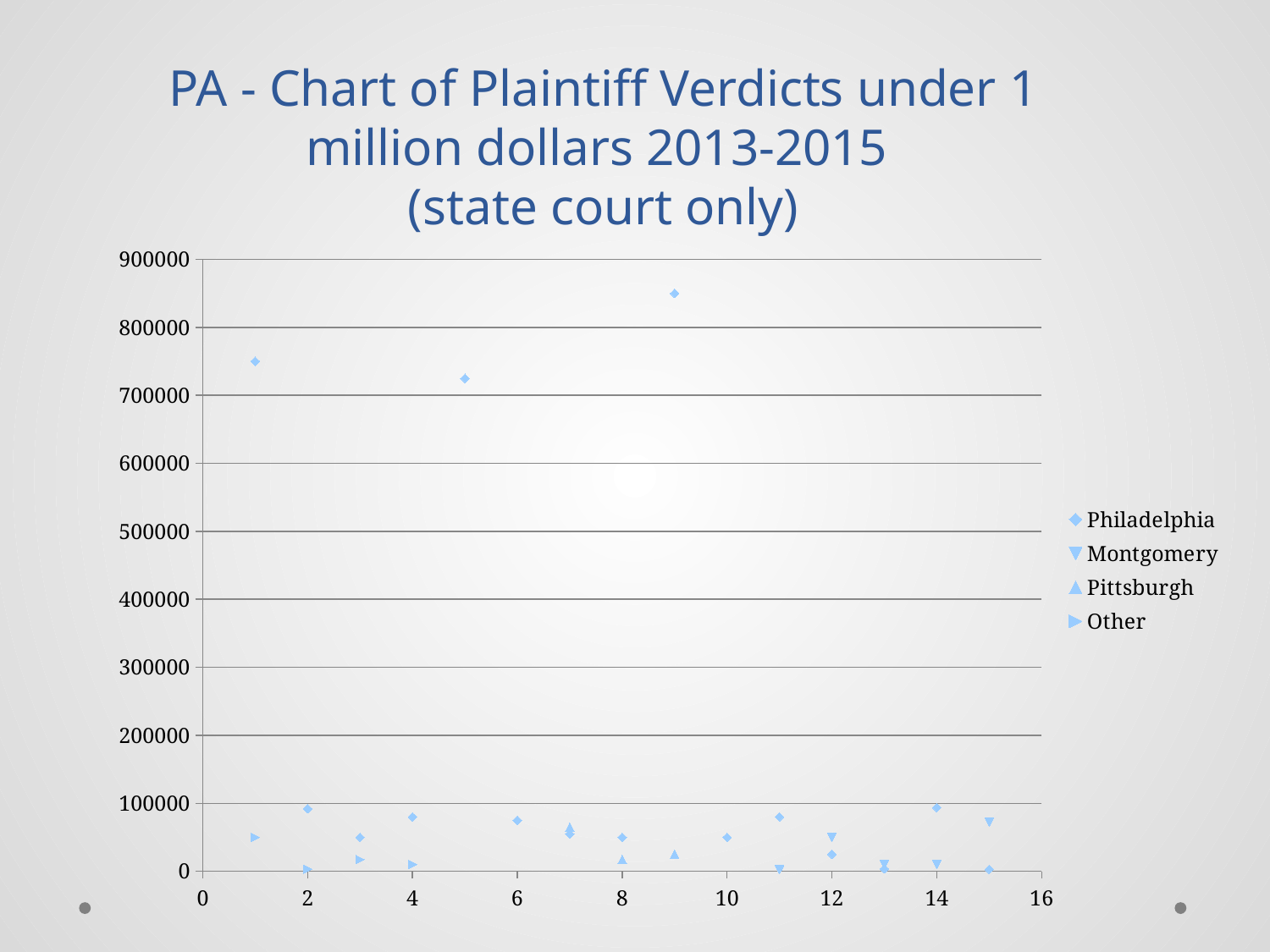
Which series has the highest plotted point on the chart? Philadelphia Is the Philadelphia point at x = 1 greater or less than 700000? greater Which is larger, the Philadelphia point at x = 9 or the Philadelphia point at x = 1? the point at x = 9 Which is larger, the Philadelphia point at x = 5 or the Montgomery point at x = 15? the Philadelphia point at x = 5 Is the Philadelphia point at x = 5 greater or less than 700000? greater Is the Other point at x = 1 greater or less than 100000? less Which series are listed in the legend? Philadelphia, Montgomery, Pittsburgh, Other What is the title of the chart? PA - Chart of Plaintiff Verdicts under 1 million dollars 2013-2015 (state court only) What kind of chart is shown on the slide? scatter chart How many series does the legend list? 4